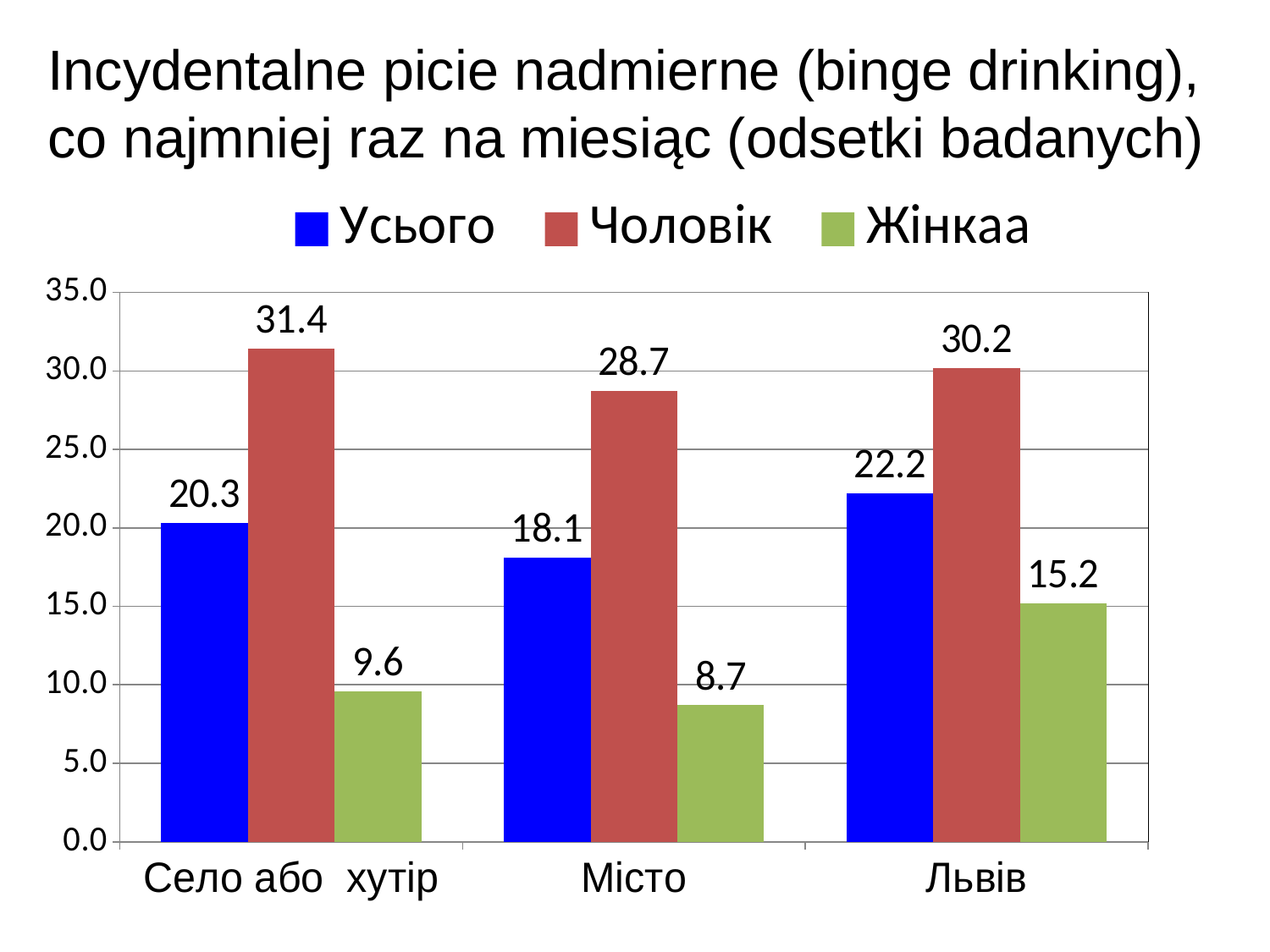
Which category has the lowest value for the Жінкаа series? Місто What is the value for Жінкаа in the Львів category? 15.2 What is the value for Чоловік in the Село або хутір category? 31.4 Which colour represents the Жінкаа series? green What is the difference between the Чоловік and Жінкаа values in the Львів category? 15.0 How many categories are shown on the x axis? 3 What kind of chart is shown on the slide? bar chart Which is larger: the Усього value for Львів or the Усього value for Село або хутір? Львів Which category has the highest value for the Чоловік series? Село або хутір What is the value for Усього in the Місто category? 18.1 Is the value for Чоловік in Місто greater or less than 25.0? greater How many series does the legend list? 3